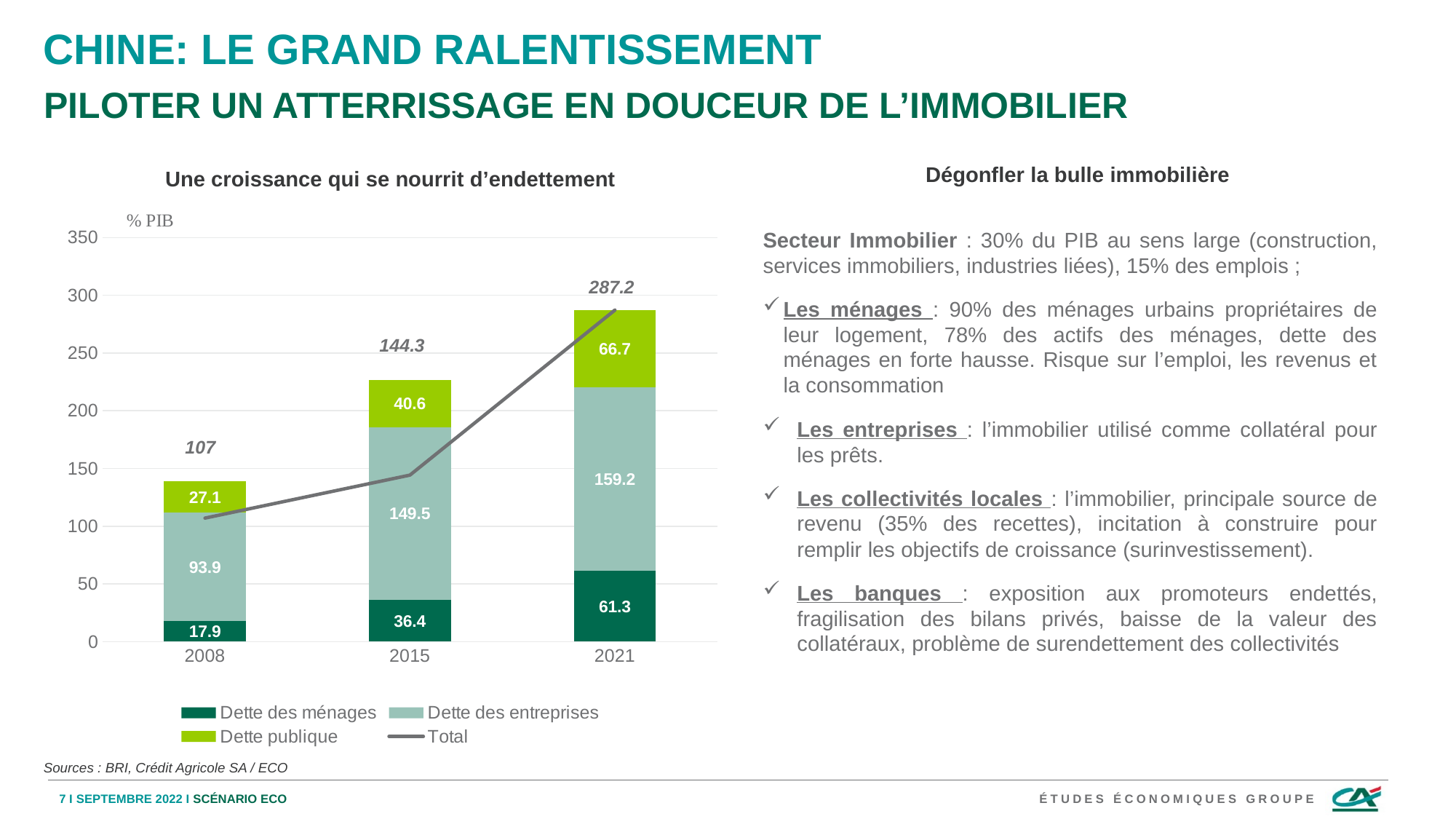
What is the value of Dette publique in 2008? 27.1 What kind of chart is shown on the slide? Stacked bar chart with a line What is the difference between Dette publique in 2021 and in 2015? 26.1 In which year is Dette des entreprises highest? 2021 In which year is Dette des ménages lowest? 2008 What value does the Total line show for 2021? 287.2 What is the value of Dette des entreprises in 2015? 149.5 Does the Total line rise or fall from 2008 to 2021? Rise How many years are shown on the x axis? 3 Which is larger in 2015: Dette des ménages or Dette publique? Dette publique How many series does the legend list? 4 What is the value of Dette des ménages in 2021? 61.3